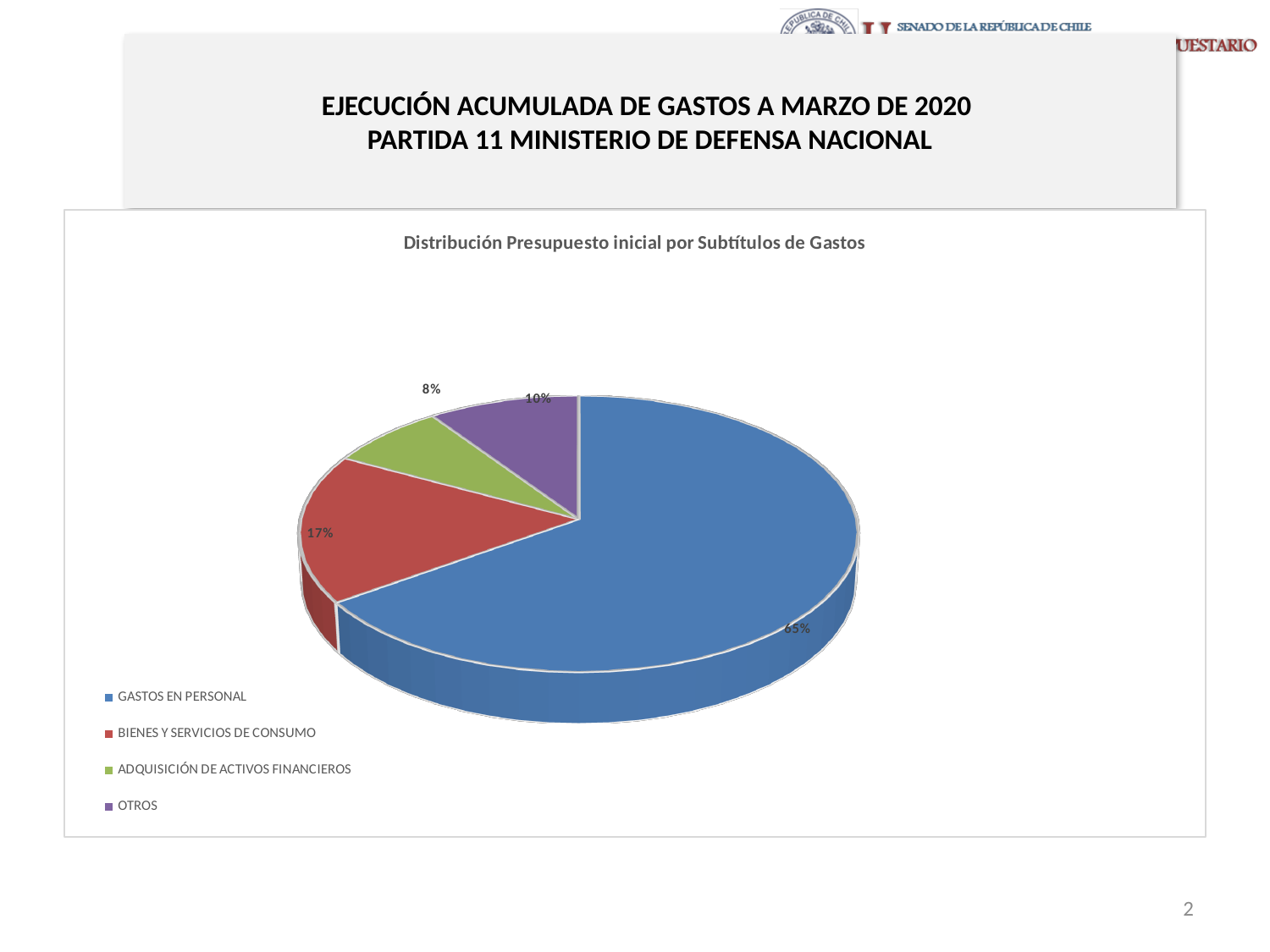
What share of the pie does OTROS represent? 10% How many categories does the pie chart show? 4 Which category has the largest slice of the pie? GASTOS EN PERSONAL What is the title of the chart? Distribución Presupuesto inicial por Subtítulos de Gastos Which category has the smallest slice of the pie? ADQUISICIÓN DE ACTIVOS FINANCIEROS What share of the pie does GASTOS EN PERSONAL represent? 65% Which colour represents BIENES Y SERVICIOS DE CONSUMO in the chart? Red Which is larger, the share for OTROS or the share for ADQUISICIÓN DE ACTIVOS FINANCIEROS? OTROS What share of the pie does BIENES Y SERVICIOS DE CONSUMO represent? 17% What is the difference in percentage points between GASTOS EN PERSONAL and BIENES Y SERVICIOS DE CONSUMO? 48 What kind of chart is shown on the slide? Pie chart